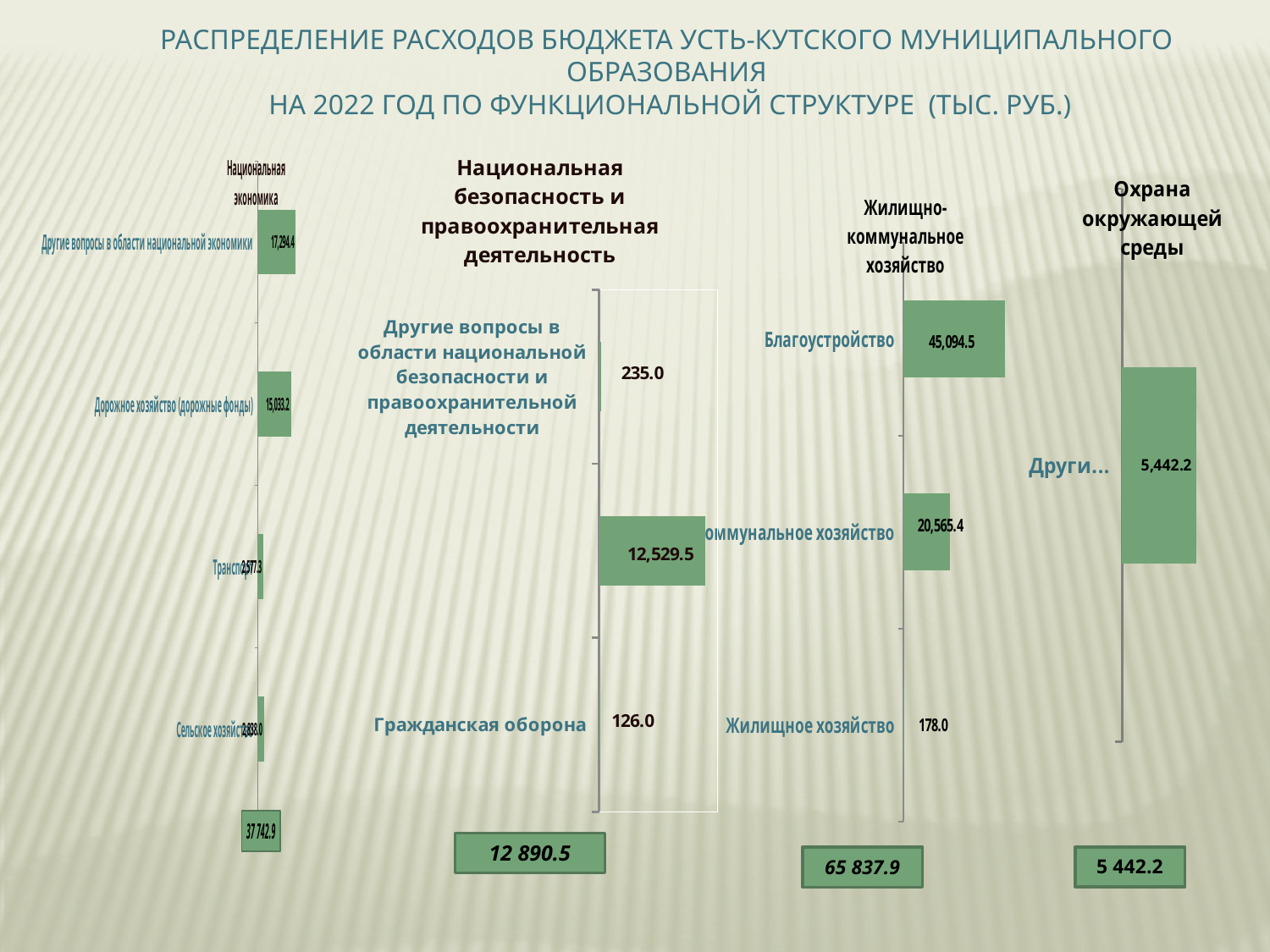
What kind of chart is the Охрана окружающей среды chart? bar chart In the Жилищно-коммунальное хозяйство chart, what is the difference between Благоустройство and Коммунальное хозяйство? 24,529.1 In the Жилищно-коммунальное хозяйство chart, what is the value for Жилищное хозяйство? 178.0 In the Национальная экономика chart, what is the value for Другие вопросы в области национальной экономики? 17,294.4 In the Национальная экономика chart, what is the value for Дорожное хозяйство (дорожные фонды)? 15,033.2 In the Национальная безопасность и правоохранительная деятельность chart, which is larger: Гражданская оборона or Другие вопросы в области национальной безопасности и правоохранительной деятельности? Другие вопросы в области национальной безопасности и правоохранительной деятельности In the Национальная безопасность и правоохранительная деятельность chart, what is the value for Гражданская оборона? 126.0 In the Жилищно-коммунальное хозяйство chart, which category has the lowest value? Жилищное хозяйство In the Жилищно-коммунальное хозяйство chart, what is the value for Коммунальное хозяйство? 20,565.4 In the Национальная безопасность и правоохранительная деятельность chart, what is the value for Другие вопросы в области национальной безопасности и правоохранительной деятельности? 235.0 In the Жилищно-коммунальное хозяйство chart, which category has the highest value? Благоустройство In the Жилищно-коммунальное хозяйство chart, what is the value for Благоустройство? 45,094.5